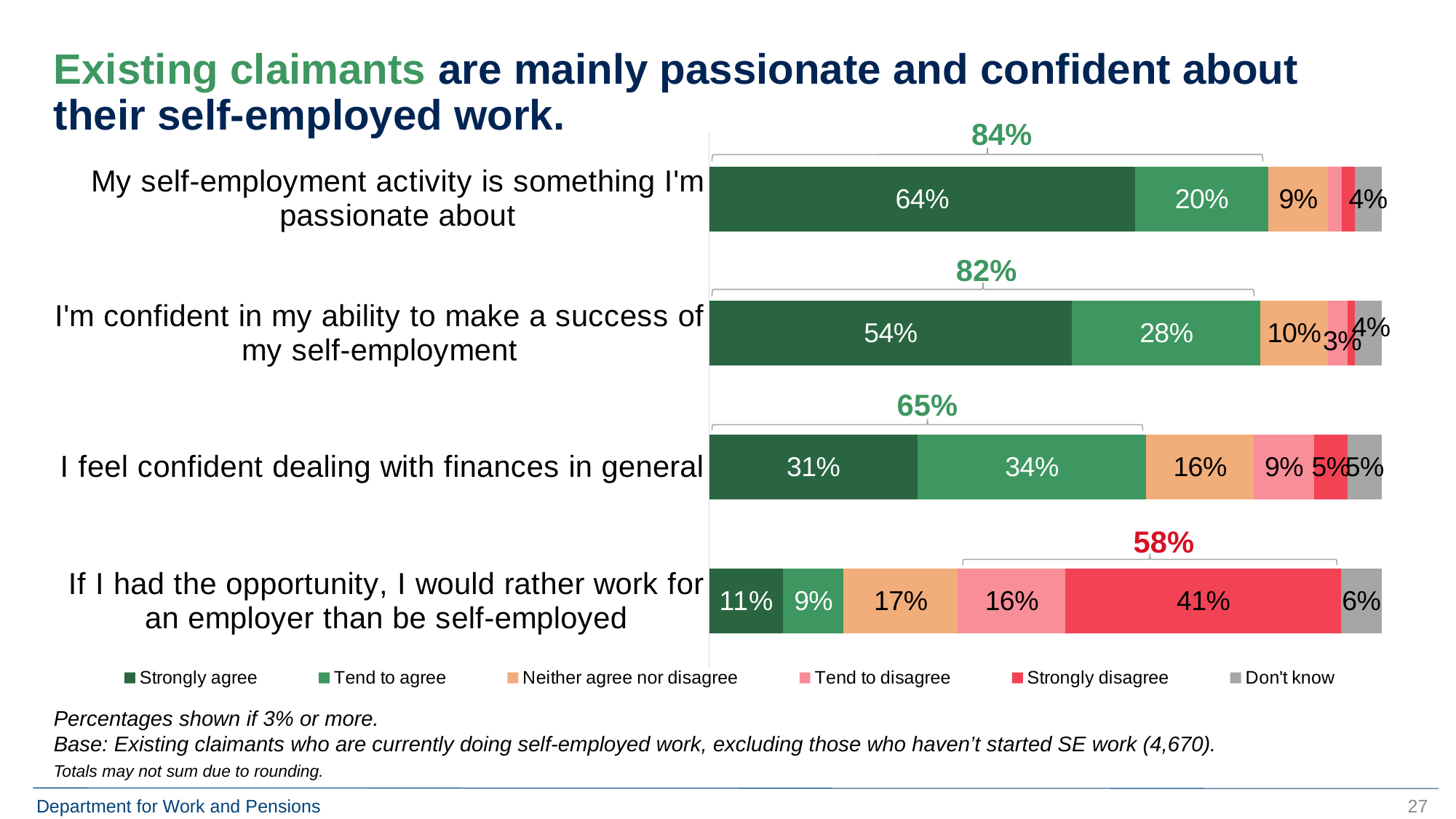
Which statement has the lowest "Strongly agree" percentage? If I had the opportunity, I would rather work for an employer than be self-employed What is the combined agreement figure shown above the bar for "I'm confident in my ability to make a success of my self-employment"? 82% What percentage of existing claimants strongly agree that their self-employment activity is something they're passionate about? 64% Which legend entry is shown in grey? Don't know How many response categories does the legend list? 6 What is the difference between the "Strongly agree" percentages for the passionate statement (64%) and the confident-in-success statement (54%)? 10 percentage points Which statement has the highest "Strongly agree" percentage? My self-employment activity is something I'm passionate about What percentage strongly disagree with the statement "If I had the opportunity, I would rather work for an employer than be self-employed"? 41% What percentage tend to agree that they feel confident dealing with finances in general? 34% What type of chart is shown on the slide? Stacked bar chart How many statements are plotted in the chart? 4 For "I feel confident dealing with finances in general", which is larger: "Strongly agree" or "Tend to agree"? Tend to agree